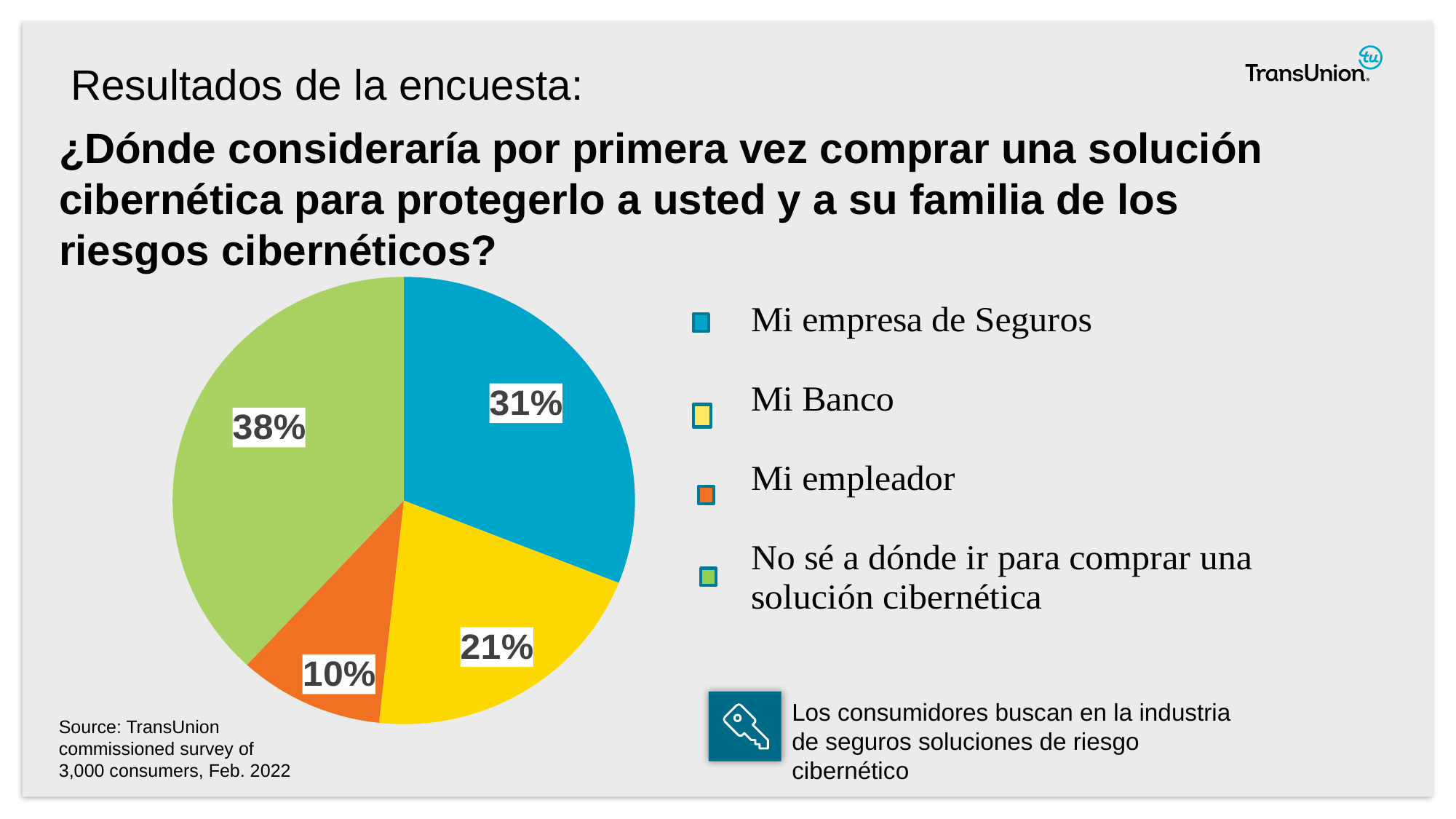
What is the difference in percentage points between "Mi empresa de Seguros" and "Mi Banco"? 10 What percentage of respondents chose "Mi Banco"? 21% How many categories does the pie chart have? 4 What percentage of respondents chose "Mi empresa de Seguros"? 31% Which category has the smallest share of the pie? Mi empleador What is the difference in percentage points between the largest and smallest slices? 28 What percentage of respondents chose "No sé a dónde ir para comprar una solución cibernética"? 38% Which is larger: the share for "Mi Banco" or the share for "Mi empleador"? Mi Banco What kind of chart is shown on the slide? pie chart What colour is the slice for "Mi empleador"? orange Which category has the largest share of the pie? No sé a dónde ir para comprar una solución cibernética What percentage of respondents chose "Mi empleador"? 10%